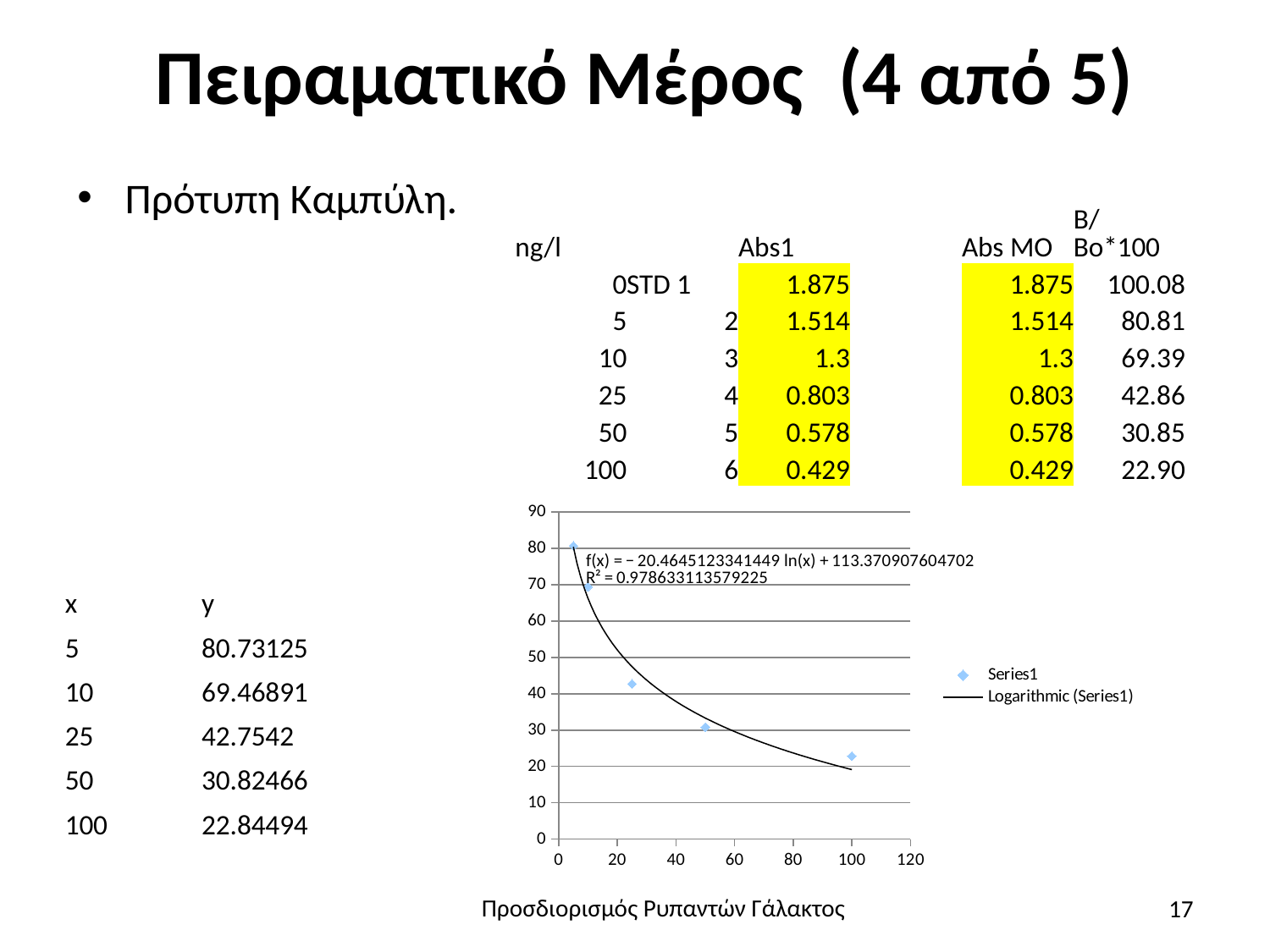
Is the plotted value at x = 100 greater or less than 20? greater How many data points are plotted in the chart? 5 Is the plotted value at x = 5 greater or less than 70? greater At which x value is the plotted point lowest? 100 What kind of chart is shown on the slide? scatter chart At which x value is the plotted point highest? 5 Is the plotted value at x = 25 greater or less than 50? less Do the plotted values rise or fall as x increases along the x axis? fall Which plotted point has the larger value, the one at x = 25 or the one at x = 50? x = 25 What type of trendline is fitted to Series1 according to the legend? Logarithmic What R² value is printed on the chart? 0.978633113579225 How many entries does the chart legend list? 2